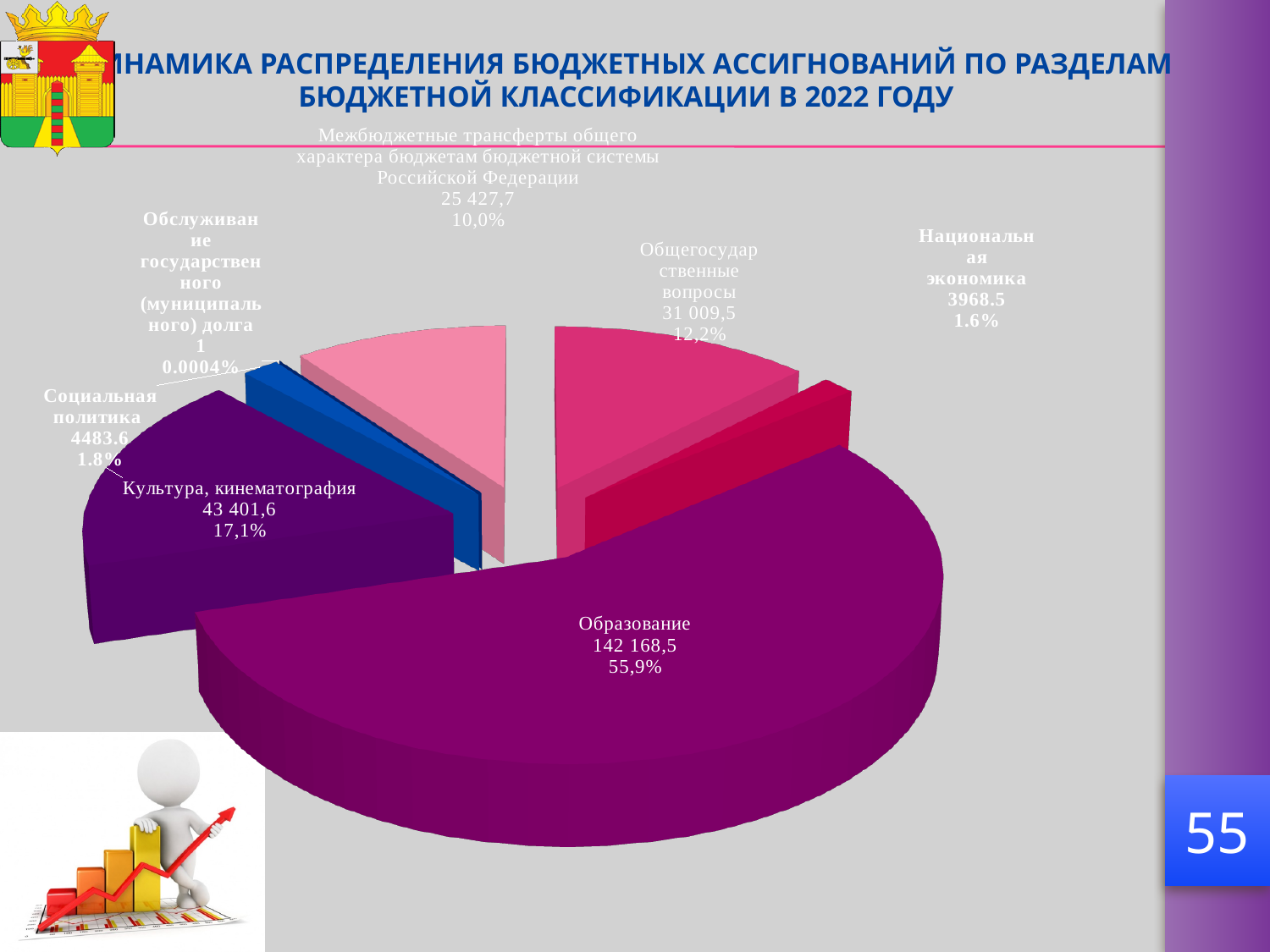
What share of the pie does Межбюджетные трансферты общего характера бюджетам бюджетной системы Российской Федерации represent? 10,0% What is the value shown for Культура, кинематография? 43 401,6 What is the value shown for Национальная экономика? 3968.5 What is the value shown for Общегосударственные вопросы? 31 009,5 Which category has the largest slice of the pie? Образование Which is larger, Культура, кинематография or Общегосударственные вопросы? Культура, кинематография How many categories (slices) does the pie chart show? 7 What is the difference between the values for Культура, кинематография and Общегосударственные вопросы? 12 392,1 Which category has the smallest slice of the pie? Обслуживание государственного (муниципального) долга What kind of chart is shown on the slide? Pie chart What is the value shown for Образование? 142 168,5 What share of the pie does Социальная политика represent? 1.8%